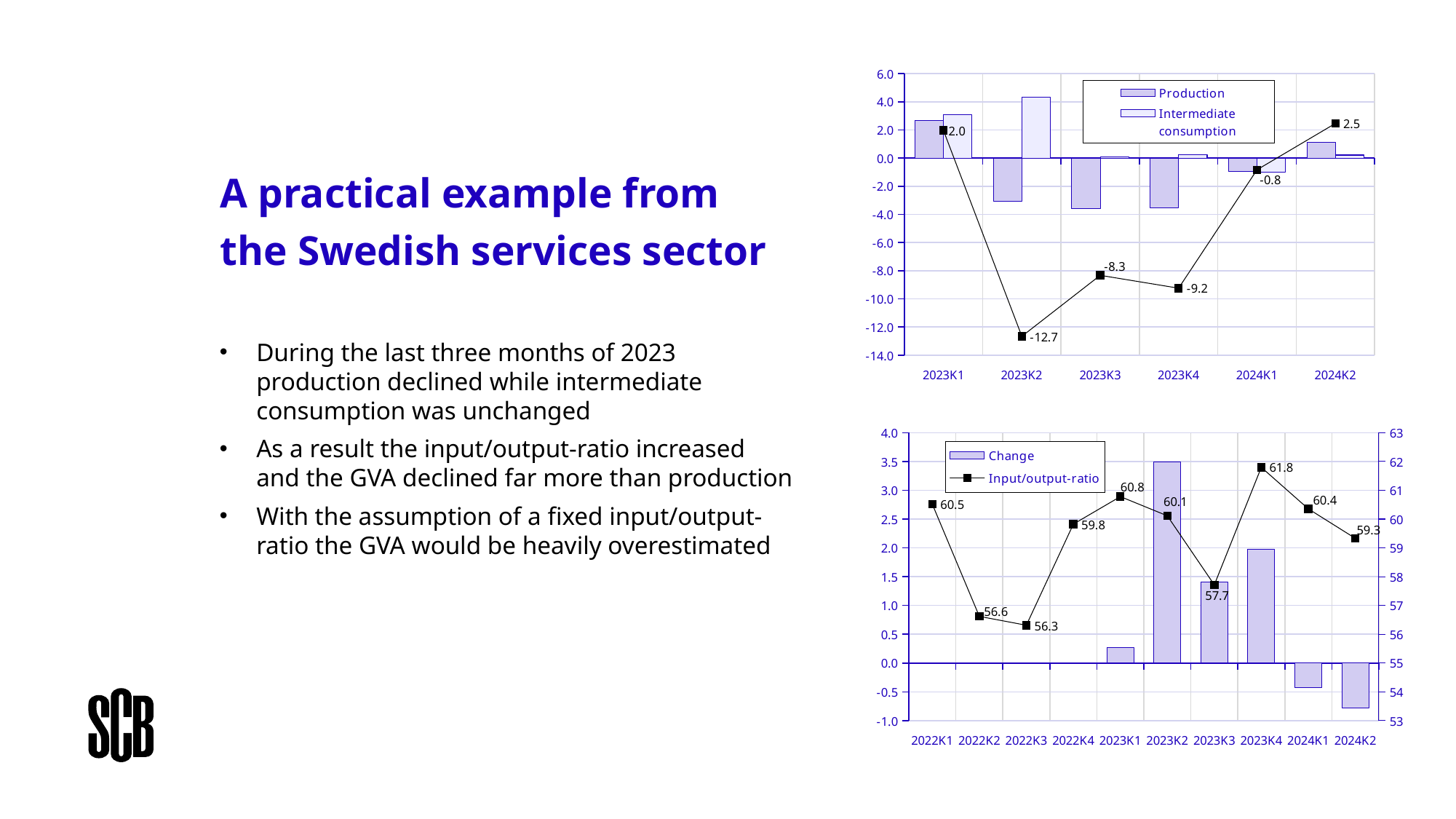
In the bottom chart, which quarter has the lowest Input/output-ratio? 2022K3 In the top chart, which is larger at 2023K1: Production or Intermediate consumption? Intermediate consumption In the bottom chart, what is the Input/output-ratio value for 2023K4? 61.8 How many quarters are shown on the x axis of the bottom chart? 10 In the bottom chart, which quarter has the highest Input/output-ratio? 2023K4 In the bottom chart, what is the difference between the Input/output-ratio in 2023K4 and in 2023K3? 4.1 How many series does the legend of the bottom chart list? 2 In the top chart, at which quarter does the labelled line reach its lowest value? 2023K2 In the bottom chart, does the Input/output-ratio rise or fall from 2023K4 to 2024K2? fall In the top chart, what value is labelled on the line at 2023K2? -12.7 In the top chart, is the Production bar for 2023K2 greater or less than -2.0? less In the bottom chart, is the Change bar for 2023K2 greater or less than 3.0? greater